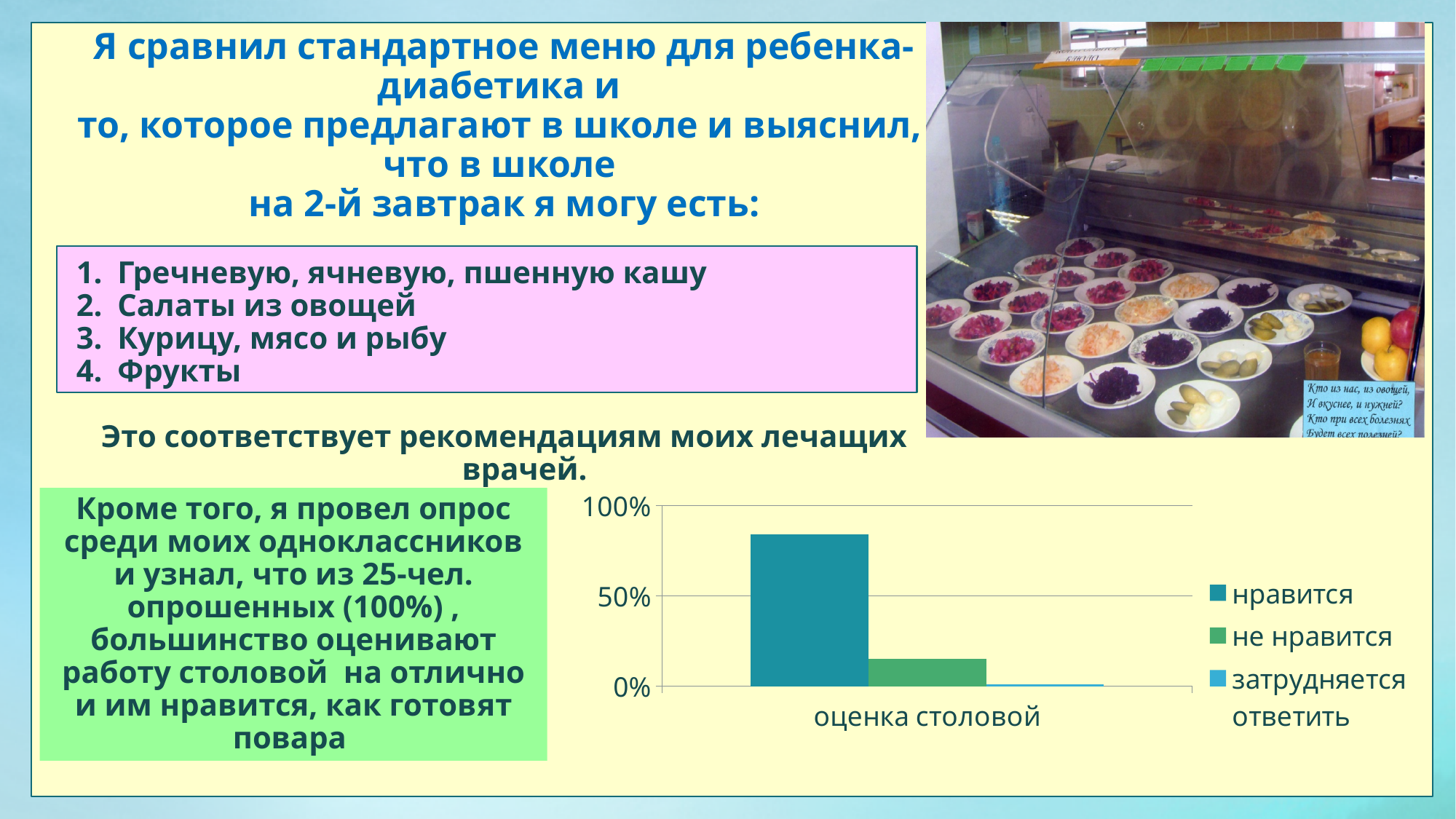
Is the value for затрудняется ответить greater or less than 50%? less Is the value for не нравится greater or less than 50%? less What is the highest value shown on the y axis of the chart? 100% How many series does the chart legend list? 3 Is the value for нравится greater or less than 50%? greater Which is larger in the chart: the value for не нравится or the value for затрудняется ответить? не нравится How many categories are shown on the x axis of the chart? 1 What is the category label shown on the x axis of the chart? оценка столовой What kind of chart is shown on the slide? bar chart Which series has the highest value in the chart? нравится Which is larger in the chart: the value for нравится or the value for не нравится? нравится Which series has the lowest value in the chart? затрудняется ответить